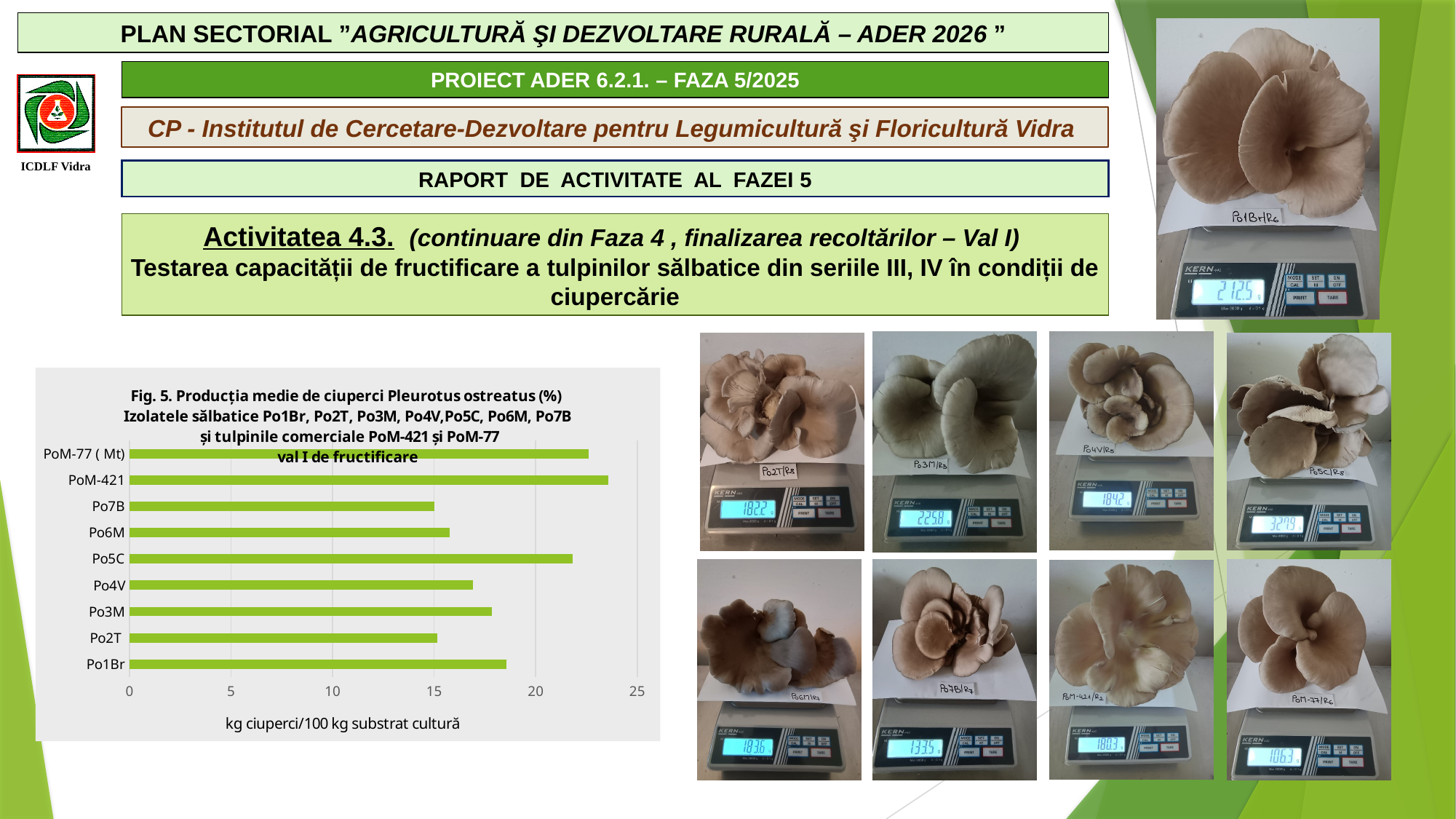
Which has the larger value, Po1Br or Po7B? Po1Br Is the value for Po7B greater or less than 20? less Is the value for Po5C greater or less than 20? greater Which has the larger value, Po5C or Po4V? Po5C Is the value for Po4V greater or less than 20? less Which strain has the highest value in the chart? PoM-421 What is the label of the horizontal axis of the chart? kg ciuperci/100 kg substrat cultură How many categories (strains) are plotted in the chart? 9 What kind of chart is shown on the slide? bar chart Which has the larger value, Po3M or Po2T? Po3M